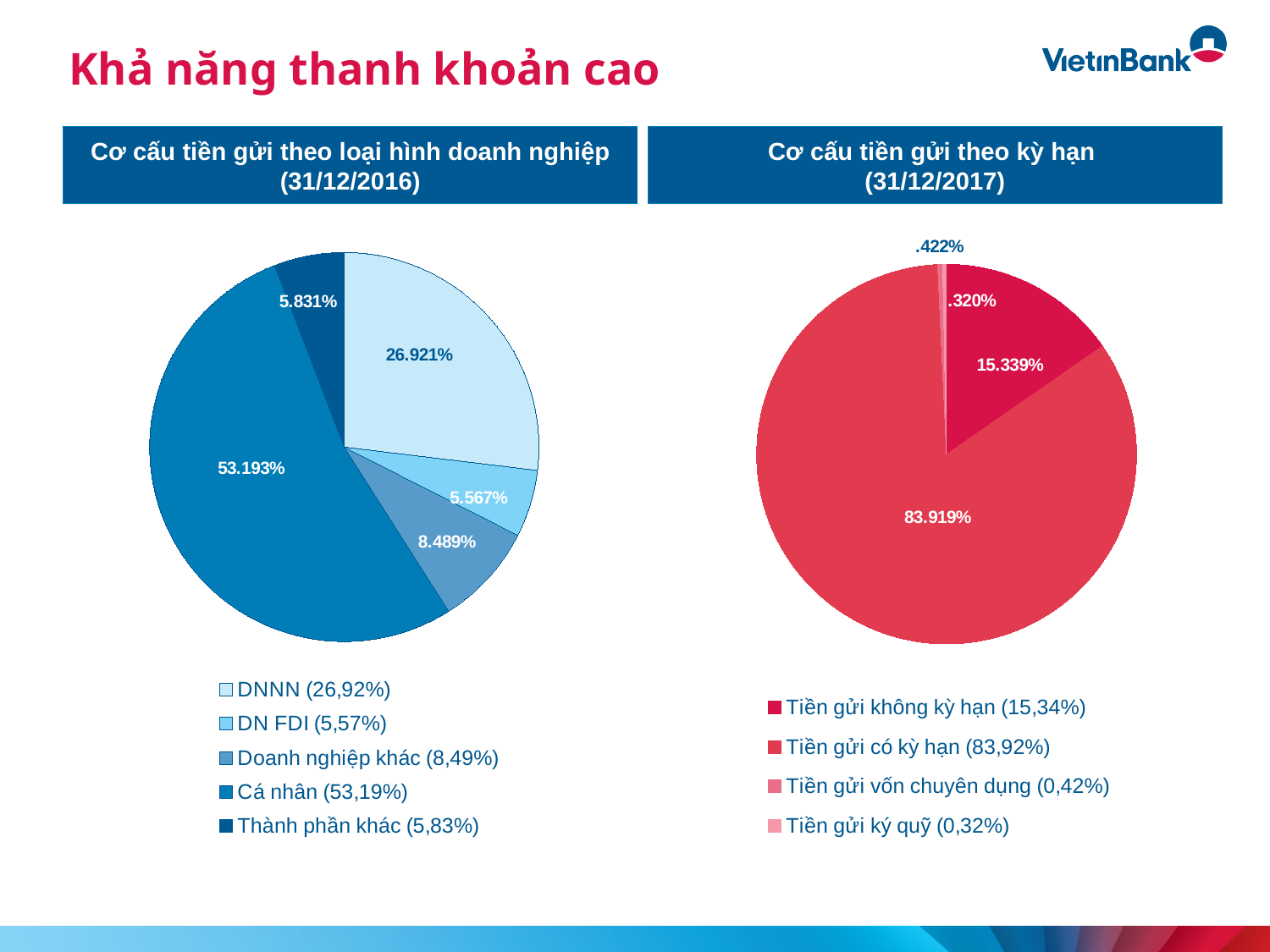
What type of chart is used for Cơ cấu tiền gửi theo kỳ hạn (31/12/2017)? Pie chart In the left chart (Cơ cấu tiền gửi theo loại hình doanh nghiệp, 31/12/2016), which is larger: Doanh nghiệp khác or Thành phần khác? Doanh nghiệp khác In the right chart (Cơ cấu tiền gửi theo kỳ hạn, 31/12/2017), how many categories does the legend list? 4 In the left chart (Cơ cấu tiền gửi theo loại hình doanh nghiệp, 31/12/2016), how many categories does the legend list? 5 In the right chart (Cơ cấu tiền gửi theo kỳ hạn, 31/12/2017), which category has the smallest share? Tiền gửi ký quỹ In the left chart (Cơ cấu tiền gửi theo loại hình doanh nghiệp, 31/12/2016), which category has the smallest share? DN FDI In the right chart (Cơ cấu tiền gửi theo kỳ hạn, 31/12/2017), what is the data label for the Tiền gửi không kỳ hạn slice? 15.339% What is the title of the chart on the left side of the slide? Cơ cấu tiền gửi theo loại hình doanh nghiệp (31/12/2016) In the left chart (Cơ cấu tiền gửi theo loại hình doanh nghiệp, 31/12/2016), which category has the largest share? Cá nhân In the right chart (Cơ cấu tiền gửi theo kỳ hạn, 31/12/2017), what is the data label for the Tiền gửi có kỳ hạn slice? 83.919% In the left chart (Cơ cấu tiền gửi theo loại hình doanh nghiệp, 31/12/2016), what is the data label for the DNNN slice? 26.921% In the left chart (Cơ cấu tiền gửi theo loại hình doanh nghiệp, 31/12/2016), what is the data label for the Cá nhân slice? 53.193%